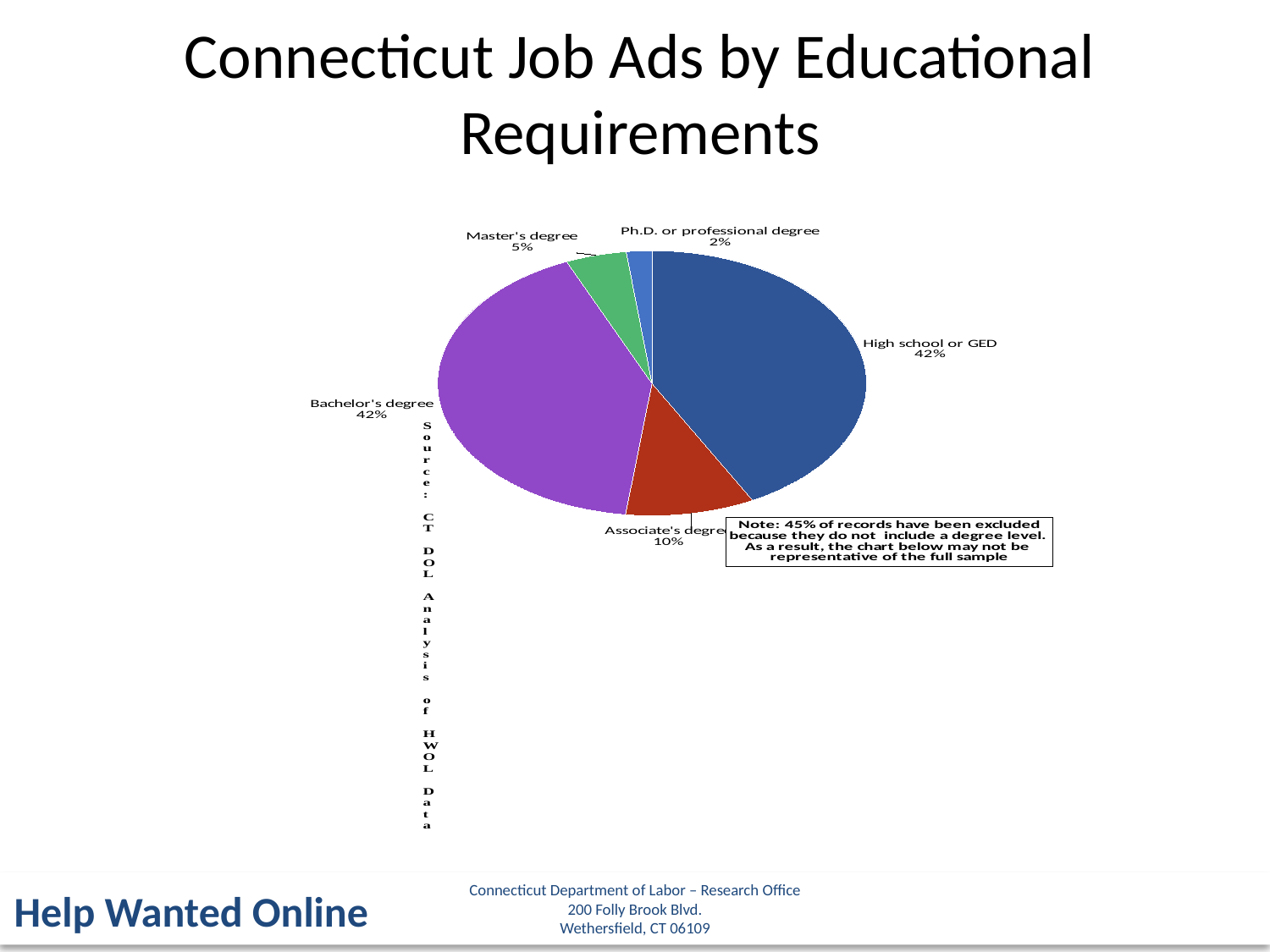
What is the difference in percentage points between the Associate's degree share and the Master's degree share? 5 What is the combined share of job ads requiring a Master's degree or a Ph.D. or professional degree? 7% What percentage of job ads require a Ph.D. or professional degree? 2% Which is larger, the share for Master's degree or the share for Ph.D. or professional degree? Master's degree What percentage of job ads require a Master's degree? 5% What kind of chart is shown on the slide? pie chart According to the note on the chart, what percentage of records were excluded because they did not include a degree level? 45% What percentage of job ads require an Associate's degree? 10% Which educational requirement has the smallest share of job ads? Ph.D. or professional degree What share of Connecticut job ads require a high school diploma or GED? 42% How many educational requirement categories are shown in the pie chart? 5 What percentage of job ads require a Bachelor's degree? 42%